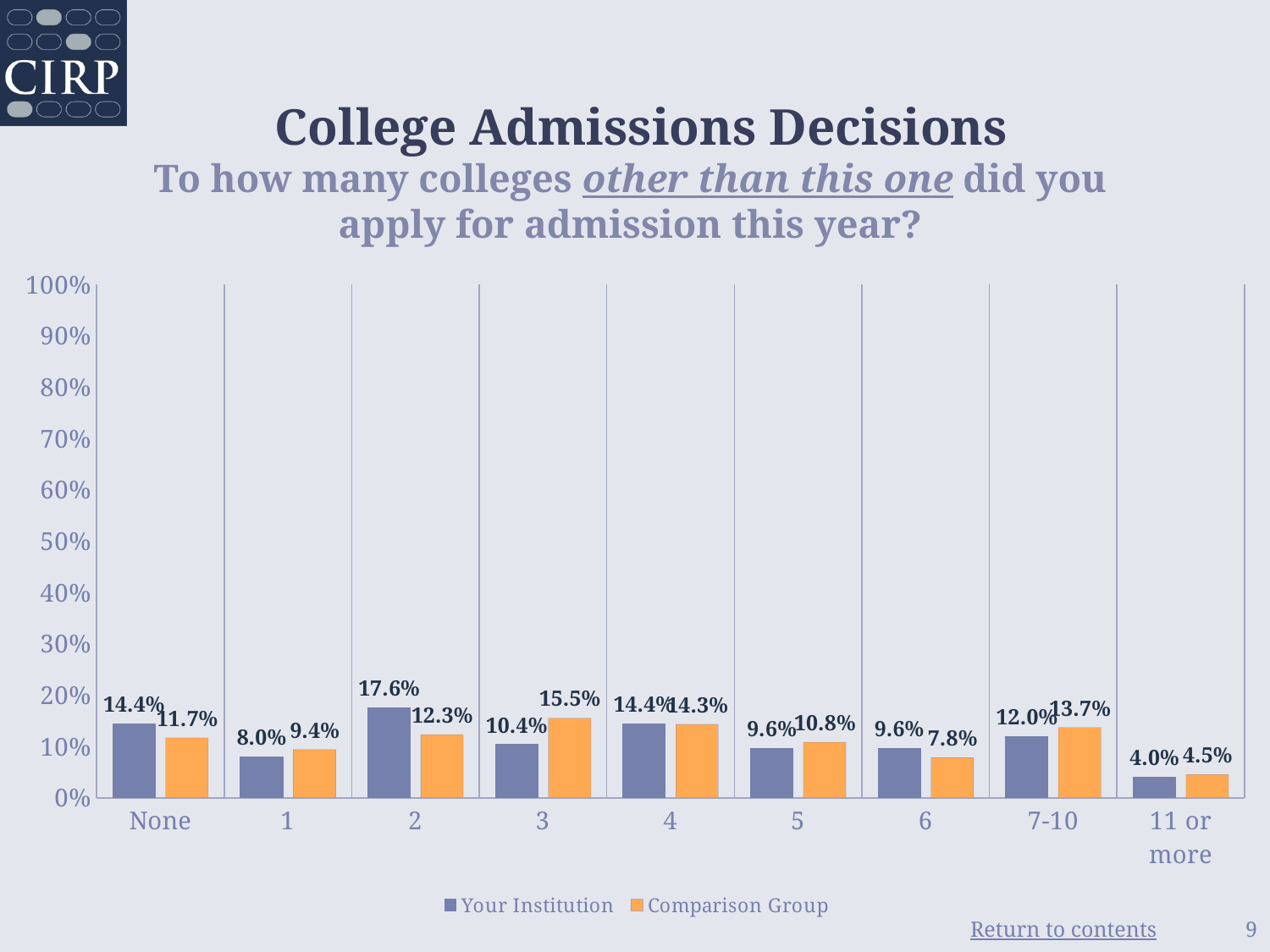
In the '3' category, which is larger: Your Institution or the Comparison Group? Comparison Group What is the value for Your Institution in the 'None' category? 14.4% How many series does the legend list? 2 What kind of chart is shown on the slide? Bar chart How many categories are shown on the x axis? 9 What is the value for the Comparison Group in the '3' category? 15.5% What is the value for the Comparison Group in the '11 or more' category? 4.5% Which category has the lowest value for the Comparison Group? 11 or more What is the difference between Your Institution and the Comparison Group in the '2' category? 5.3 percentage points What is the value for Your Institution in the '2' category? 17.6% Which category has the highest value for Your Institution? 2 Is the value for Your Institution in the '2' category greater or less than 20%? less